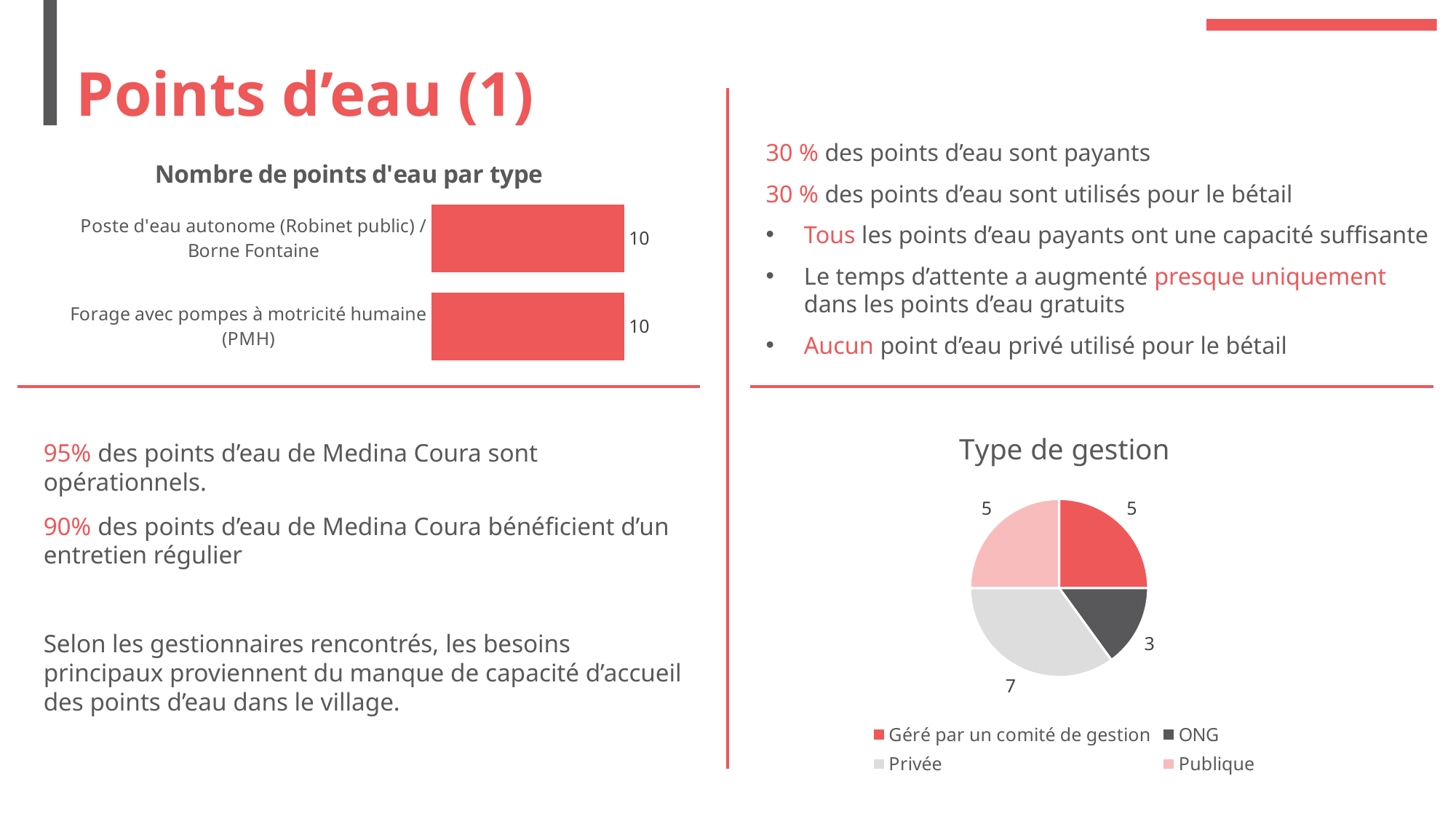
In the chart 'Type de gestion', which category has the smallest slice? ONG How many categories does the chart 'Nombre de points d'eau par type' show? 2 What kind of chart is 'Nombre de points d'eau par type'? Bar chart In the chart 'Type de gestion', what is the value for ONG? 3 In the chart 'Nombre de points d'eau par type', what is the difference between the two categories' values? 0 How many entries does the legend of the chart 'Type de gestion' list? 4 In the chart 'Type de gestion', what is the difference between Privée and ONG? 4 In the chart 'Type de gestion', which category has the largest slice? Privée In the chart 'Nombre de points d'eau par type', what is the value for Forage avec pompes à motricité humaine (PMH)? 10 In the chart 'Nombre de points d'eau par type', what is the value for Poste d'eau autonome (Robinet public) / Borne Fontaine? 10 What kind of chart is 'Type de gestion'? Pie chart In the chart 'Type de gestion', what is the value for Privée? 7